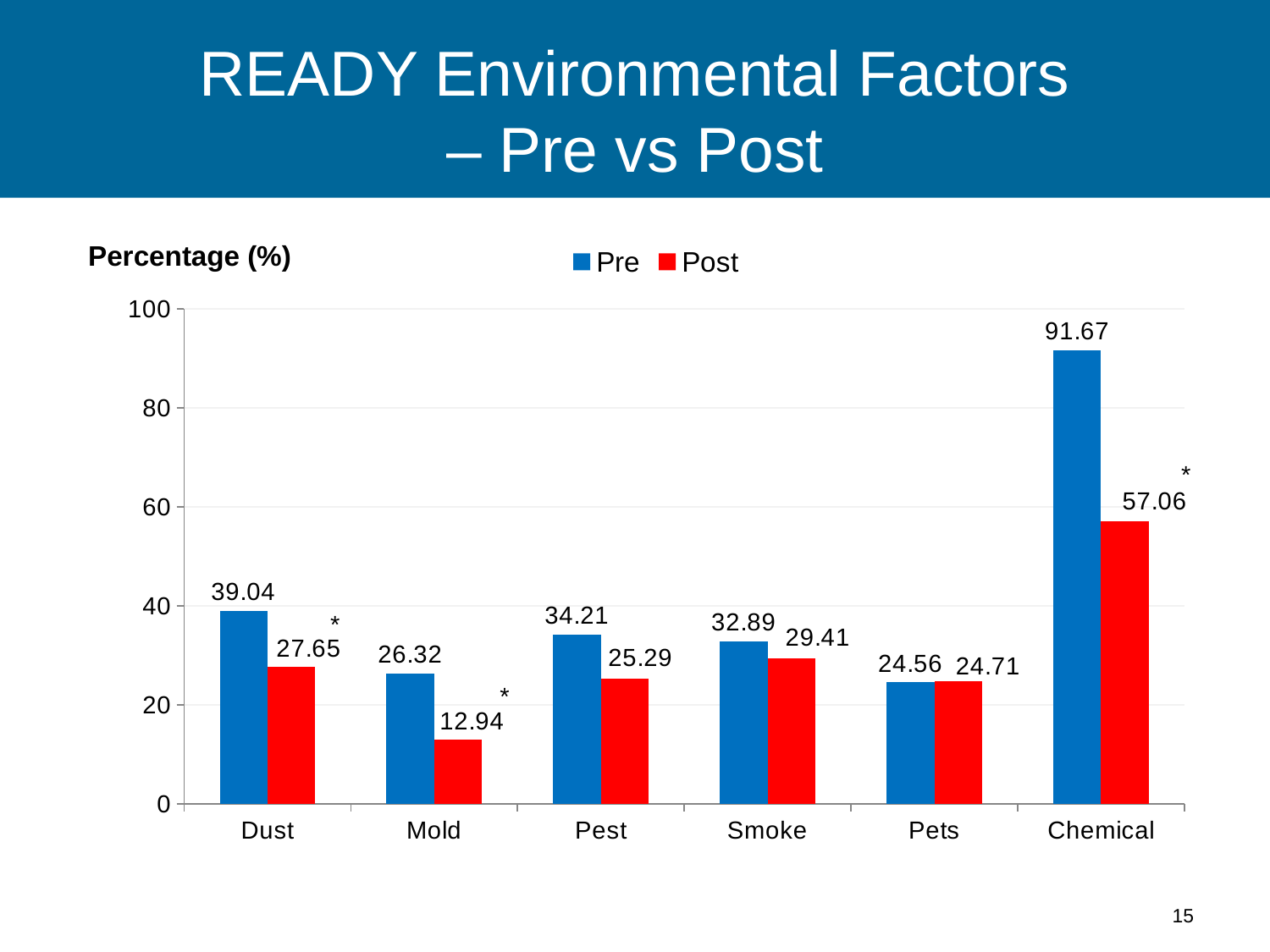
What is the Post value for Mold? 12.94 Which category has the lowest Post value? Mold What colour are the Post bars? Red How many series does the legend list? 2 What is the Pre value for Chemical? 91.67 What is the difference between the Pre and Post values for Chemical? 34.61 What is the difference between the Pre and Post values for Dust? 11.39 What is the Post value for Smoke? 29.41 Which category has the highest Pre value? Chemical What kind of chart is shown on the slide? Bar chart How many categories are shown on the x axis? 6 Which is larger, the Pre value for Pest or the Post value for Pest? Pre